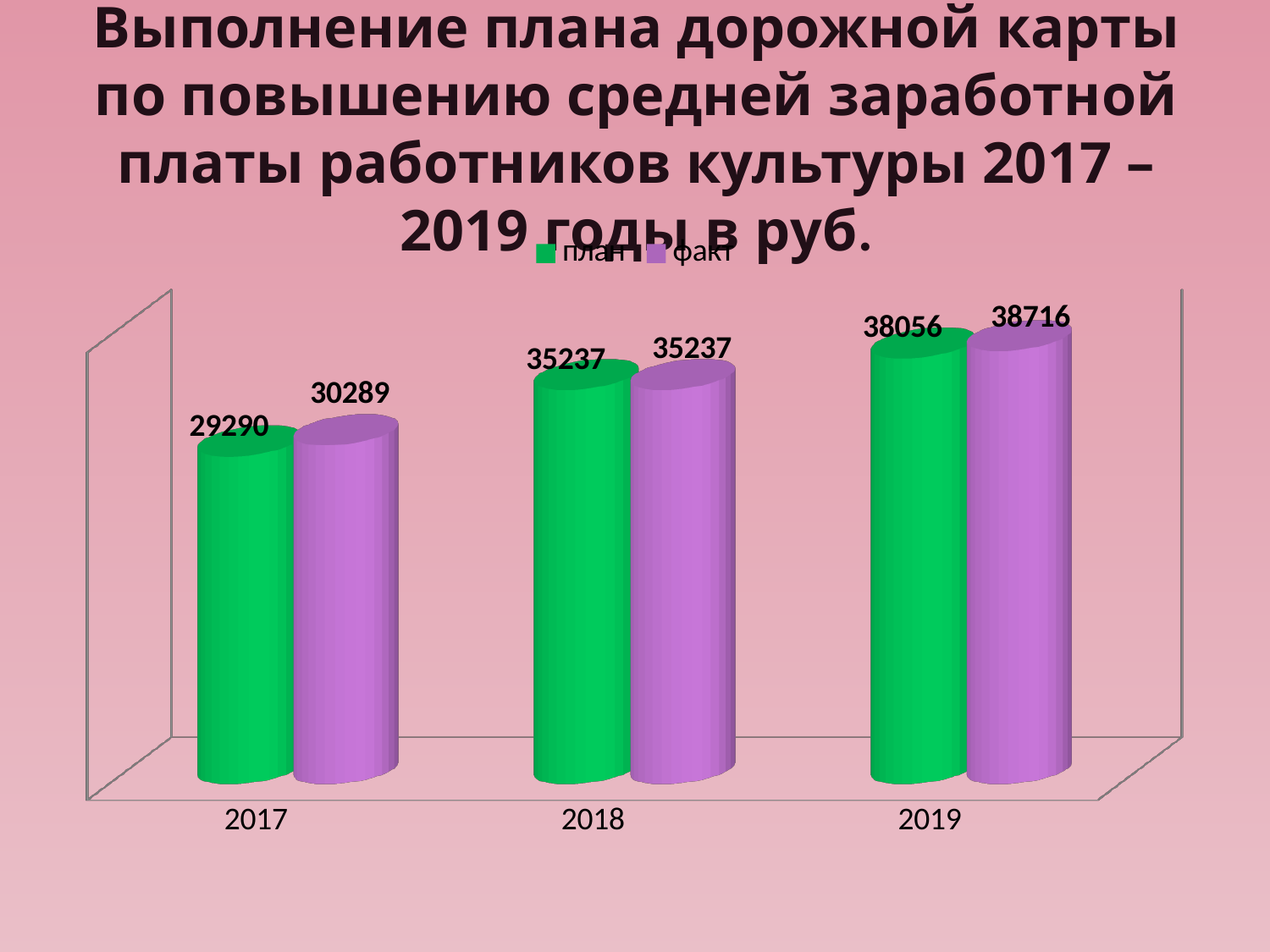
Do the план values rise or fall from 2017 to 2019? rise What is the value of факт for 2017? 30289 How many years are shown on the x axis? 3 What is the value of план for 2017? 29290 In which year is the план value lowest? 2017 Which is larger in 2017, план or факт? факт How many series does the legend list? 2 What is the value of факт for 2019? 38716 What is the value of план for 2019? 38056 In which year is the факт value highest? 2019 What is the difference between факт and план in 2019? 660 What is the difference between факт and план in 2017? 999